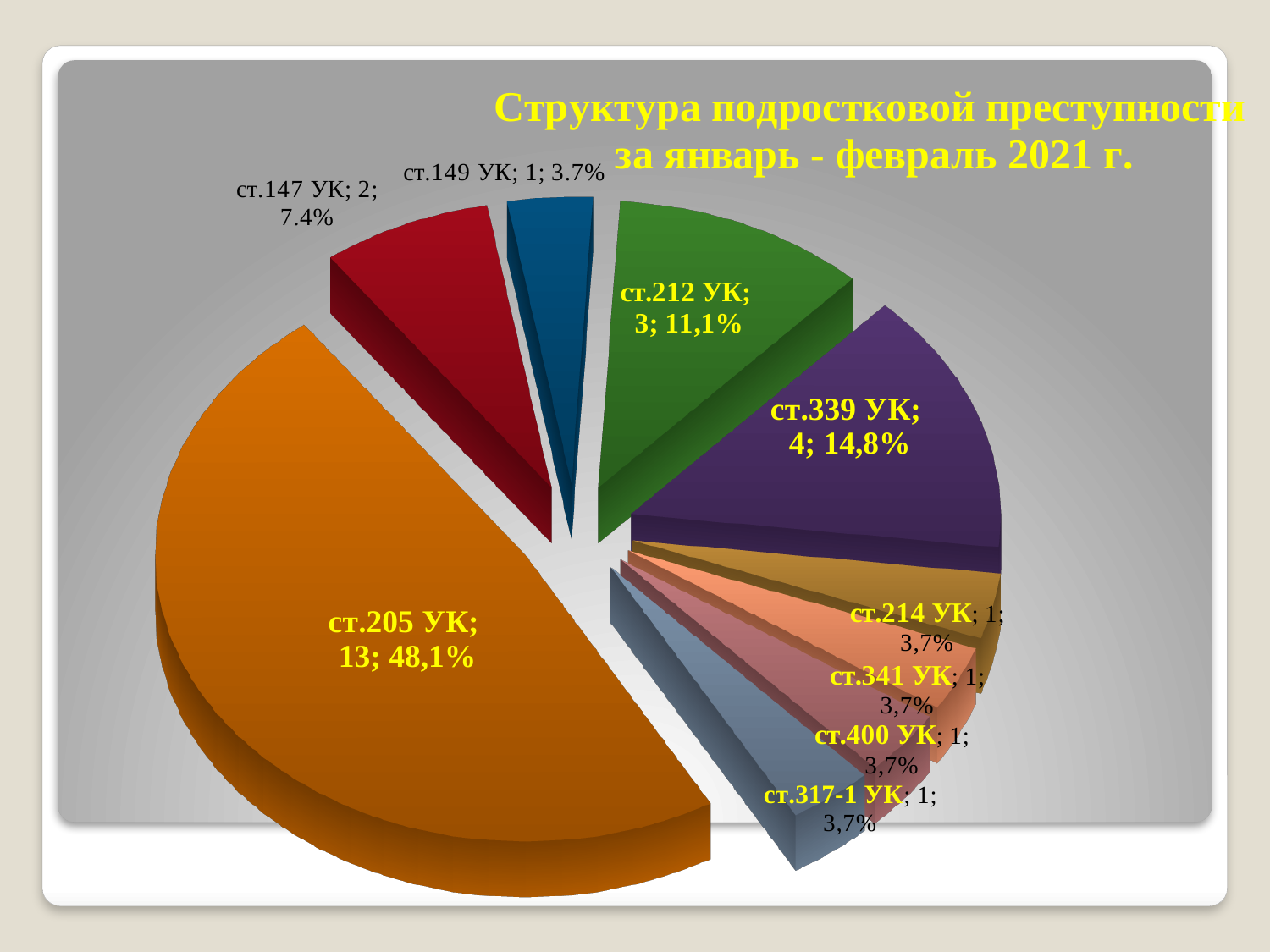
What is the title of the chart? Структура подростковой преступности за январь - февраль 2021 г. What is the difference between the counts for ст.205 УК and ст.339 УК? 9 What percentage is shown for ст.212 УК? 11,1% Which category has the largest slice? ст.205 УК What is the count shown for ст.339 УК? 4 What is the count shown for ст.317-1 УК? 1 What share of the pie does ст.205 УК represent? 48,1% What kind of chart is shown on the slide? Pie chart What percentage is shown for ст.147 УК? 7.4% What is the count shown for ст.205 УК? 13 How many slices does the pie chart have? 9 Which is larger, the count for ст.212 УК or the count for ст.147 УК? ст.212 УК